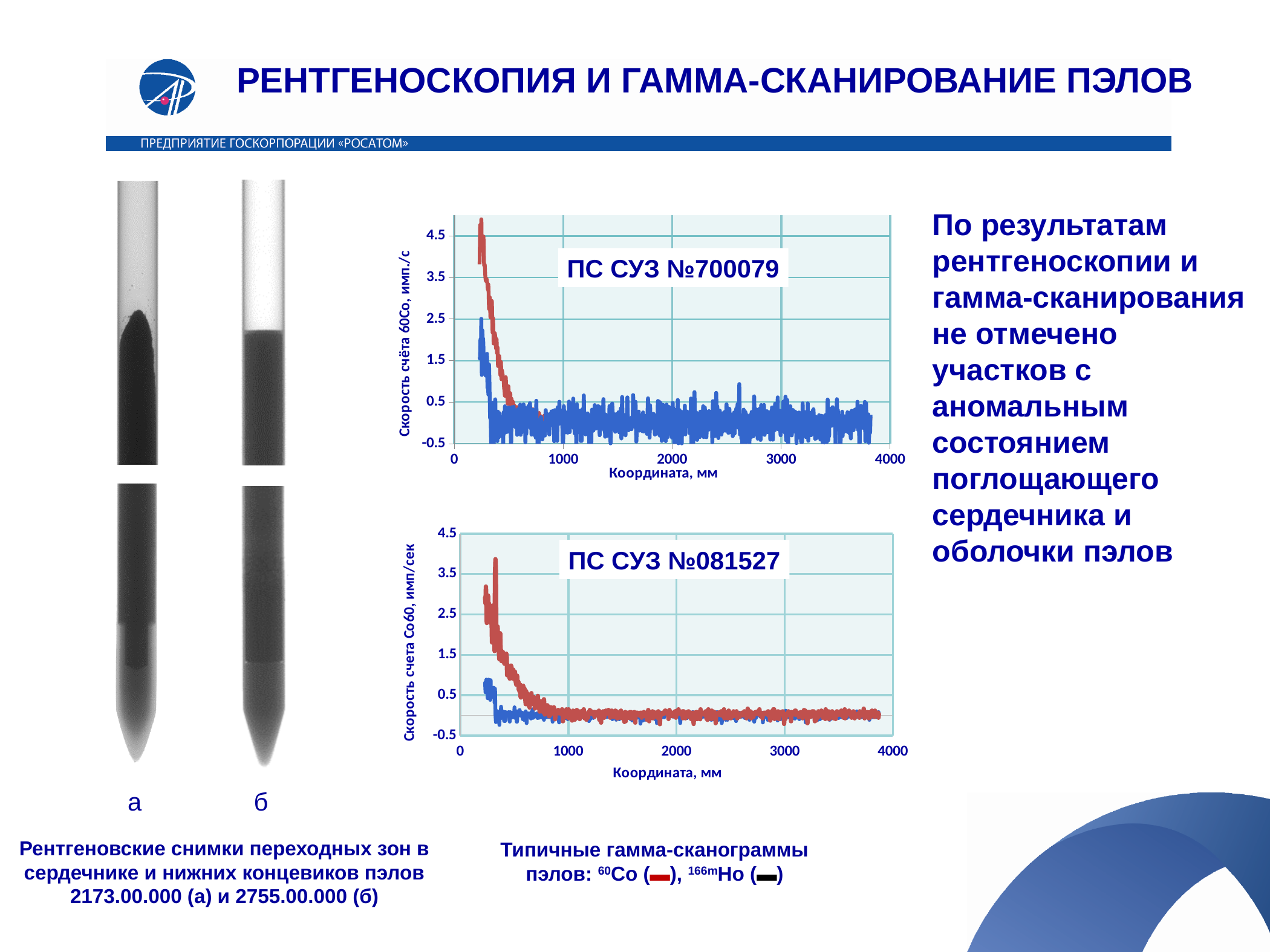
In the chart titled ПС СУЗ №081527, is the peak value of the red line greater or less than 4.5? less How many data series are plotted in the chart titled ПС СУЗ №081527? 2 What is the highest value shown on the x axis of the chart titled ПС СУЗ №700079? 4000 How many labelled tick marks are on the x axis of the chart titled ПС СУЗ №700079? 5 In the chart titled ПС СУЗ №700079, is the peak value of the red line greater or less than 3.5? greater In the chart titled ПС СУЗ №700079, near the start of the scan (around 300 mm), which line is higher, the red or the blue? red In the chart titled ПС СУЗ №700079, does the red line rise or fall as the coordinate increases from 0 to 1000 mm? fall In the chart titled ПС СУЗ №081527, is the peak value of the blue line greater or less than 1.5? less What kind of chart is the chart titled ПС СУЗ №700079? line chart What is the x-axis label of the chart titled ПС СУЗ №081527? Координата, мм In the chart titled ПС СУЗ №081527, does the red line rise or fall as the coordinate increases from 0 to 1000 mm? fall